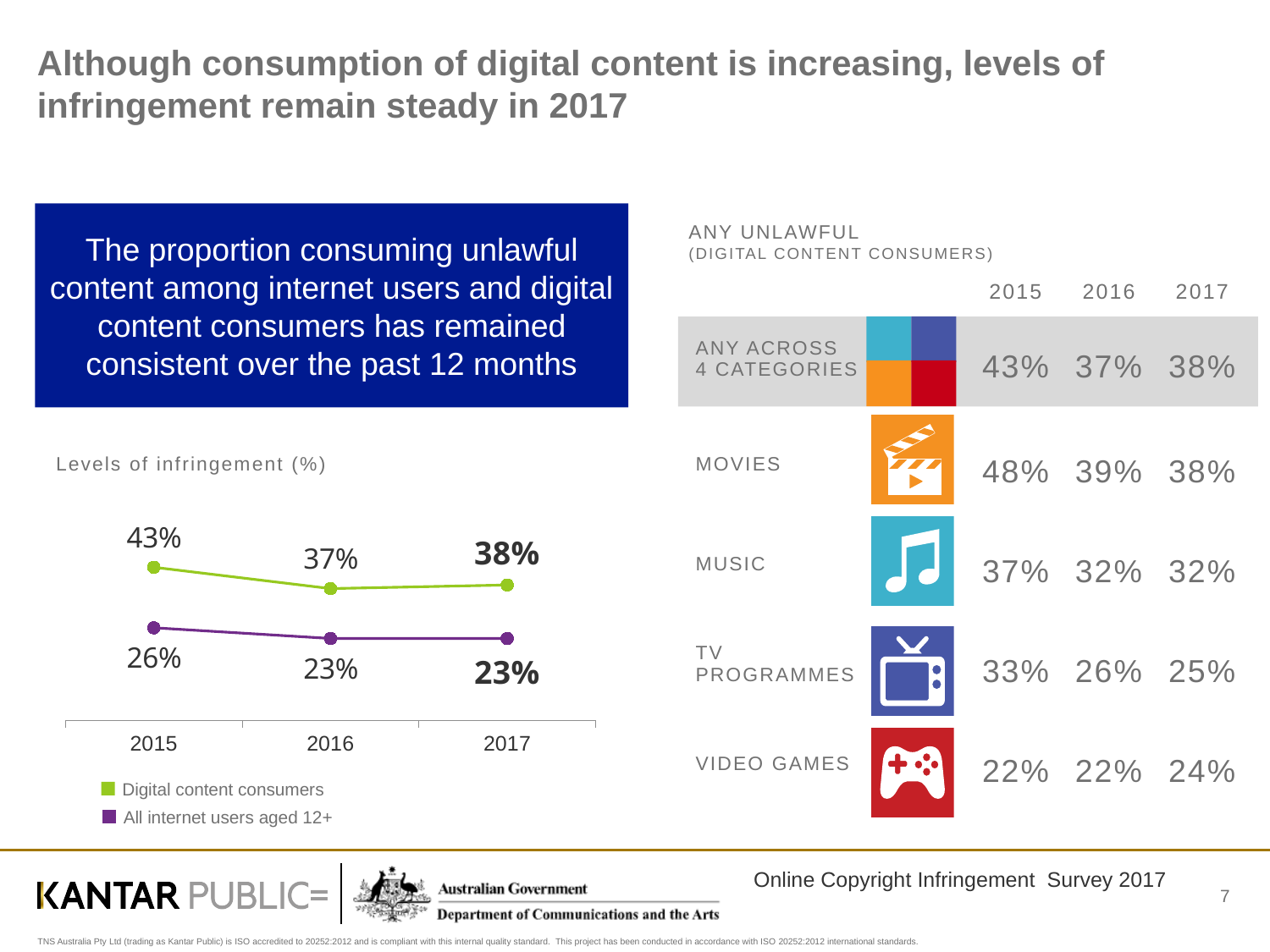
In the 'Levels of infringement (%)' chart, what is the difference between the Digital content consumers values for 2015 and 2016? 6% How many series does the legend of the 'Levels of infringement (%)' chart list? 2 In the 'Levels of infringement (%)' chart, which year has the lowest value for Digital content consumers? 2016 In the 'Levels of infringement (%)' chart, which series has the larger value in 2016: Digital content consumers or All internet users aged 12+? Digital content consumers In the 'Levels of infringement (%)' chart, what is the value for All internet users aged 12+ in 2017? 23% How many years are shown on the x axis of the 'Levels of infringement (%)' chart? 3 In the 'Levels of infringement (%)' chart, which year has the highest value for Digital content consumers? 2015 In the 'Levels of infringement (%)' chart, what is the value for Digital content consumers in 2016? 37% In the 'Levels of infringement (%)' chart, what is the value for Digital content consumers in 2015? 43% In the 'Levels of infringement (%)' chart, what is the difference between the Digital content consumers value and the All internet users aged 12+ value in 2017? 15% What kind of chart is 'Levels of infringement (%)'? Line chart In the 'Levels of infringement (%)' chart, what is the value for All internet users aged 12+ in 2015? 26%